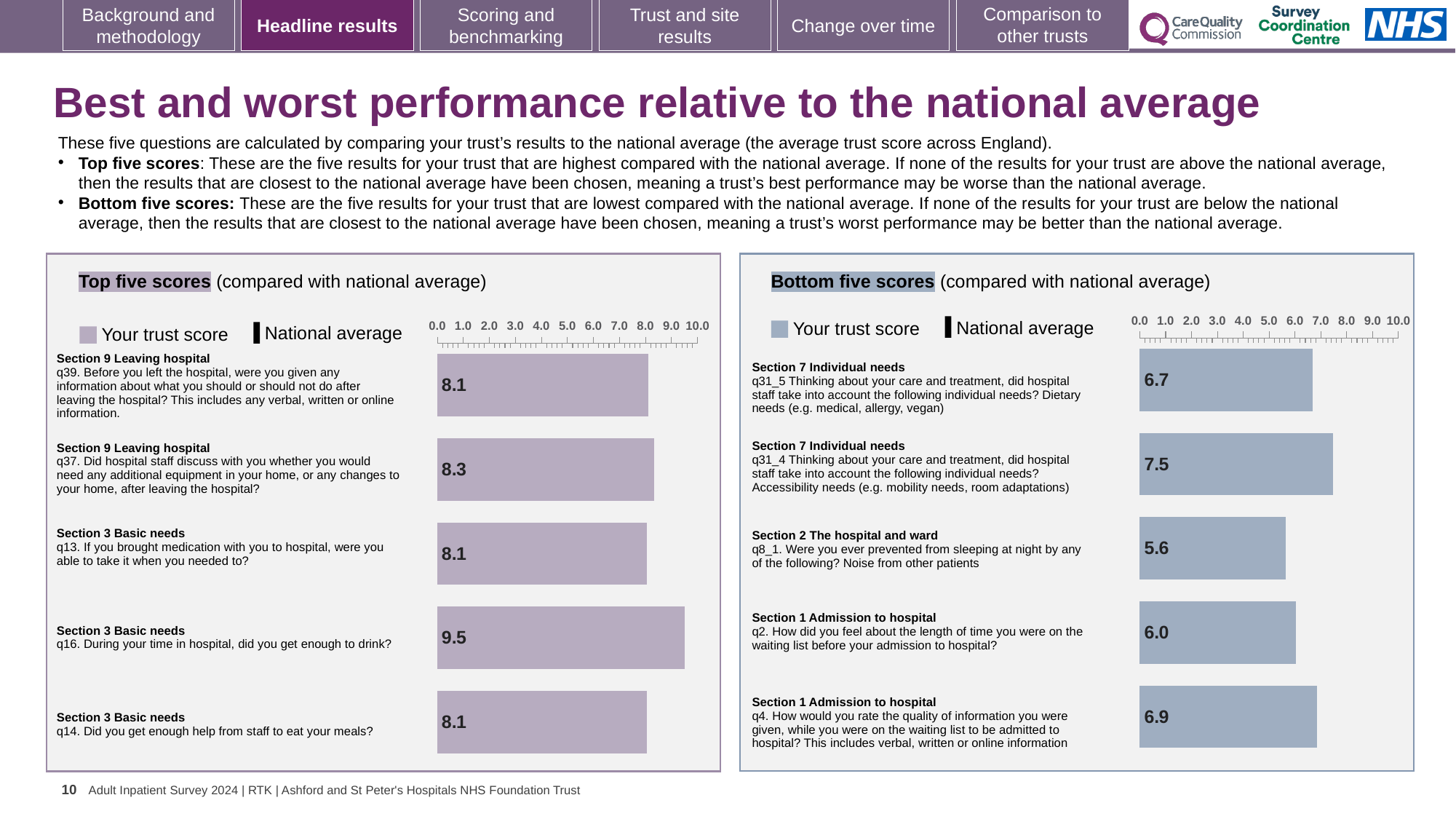
In the Bottom five scores chart, what is the trust score for q31_4 (accessibility needs)? 7.5 In the Top five scores chart, what is the difference between the scores for q16 and q37? 1.2 In the Bottom five scores chart, what is the difference between the scores for q31_4 and q8_1? 1.9 What type of chart is used in the Top five scores panel? Bar chart How many bars are shown in the Bottom five scores chart? 5 In the Top five scores chart, what is the trust score for q37 (discussing additional equipment or changes to your home)? 8.3 In the Top five scores chart, what is the trust score for q16 (did you get enough to drink)? 9.5 In the Top five scores chart, which question has the highest trust score? q16. During your time in hospital, did you get enough to drink? In the Bottom five scores chart, which question has the lowest trust score? q8_1. Were you ever prevented from sleeping at night by any of the following? Noise from other patients In the Bottom five scores chart, which question has the highest trust score? q31_4 (Accessibility needs) In the Bottom five scores chart, what is the trust score for q8_1 (prevented from sleeping by noise from other patients)? 5.6 In the Bottom five scores chart, which is larger: the score for q2 or the score for q4? q4